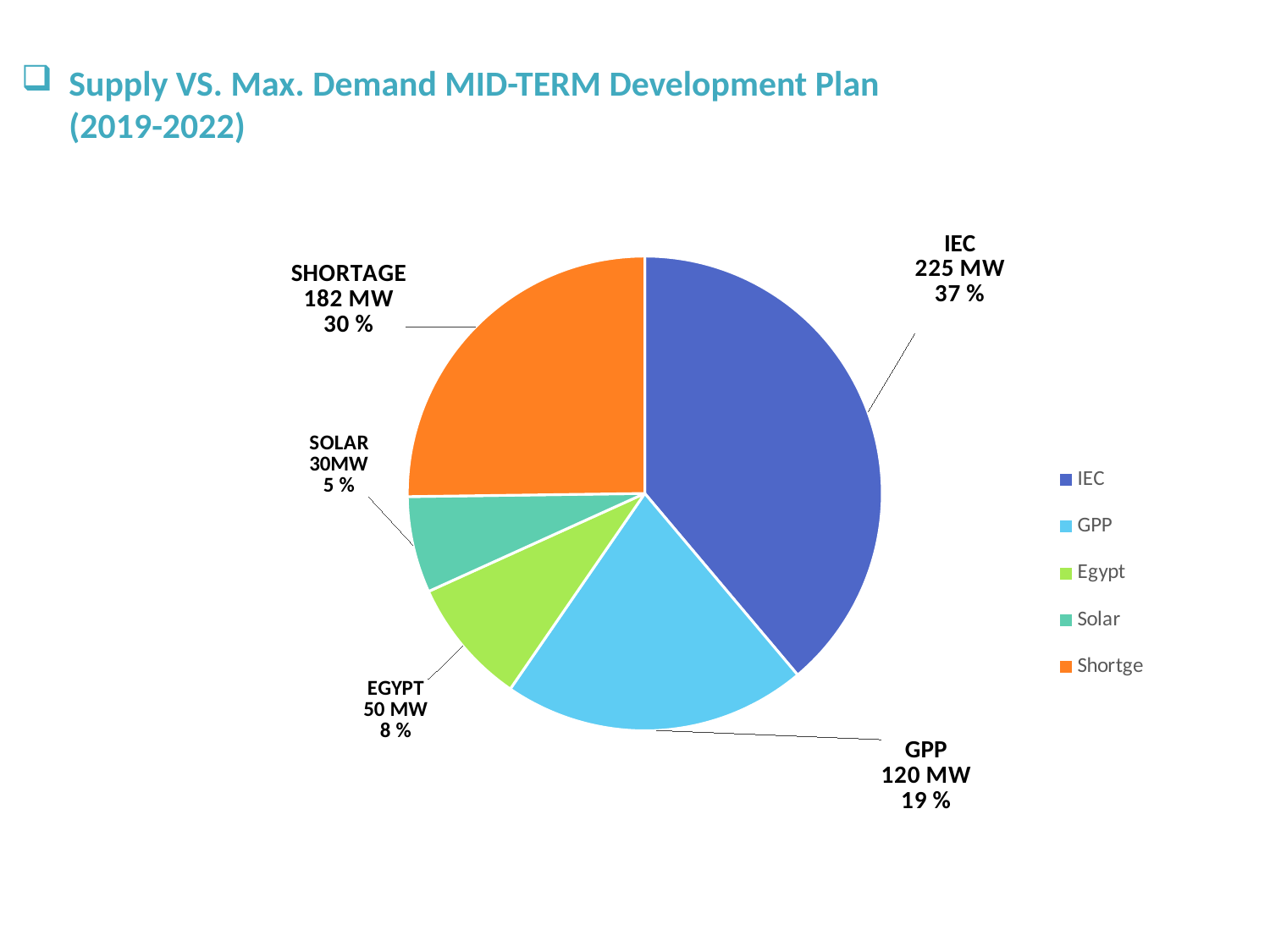
How many slices does the pie chart have? 5 What is the value in MW for Egypt? 50 MW What kind of chart is shown on the slide? pie chart What is the value in MW for GPP? 120 MW What percentage share does the Solar slice represent? 5 % What is the value in MW for IEC? 225 MW How many entries does the legend list? 5 What percentage share does the Shortage slice represent? 30 % Which is larger, the Shortage slice or the GPP slice? Shortage Which slice is the largest? IEC Which slice is the smallest? Solar What is the difference in MW between IEC and GPP? 105 MW